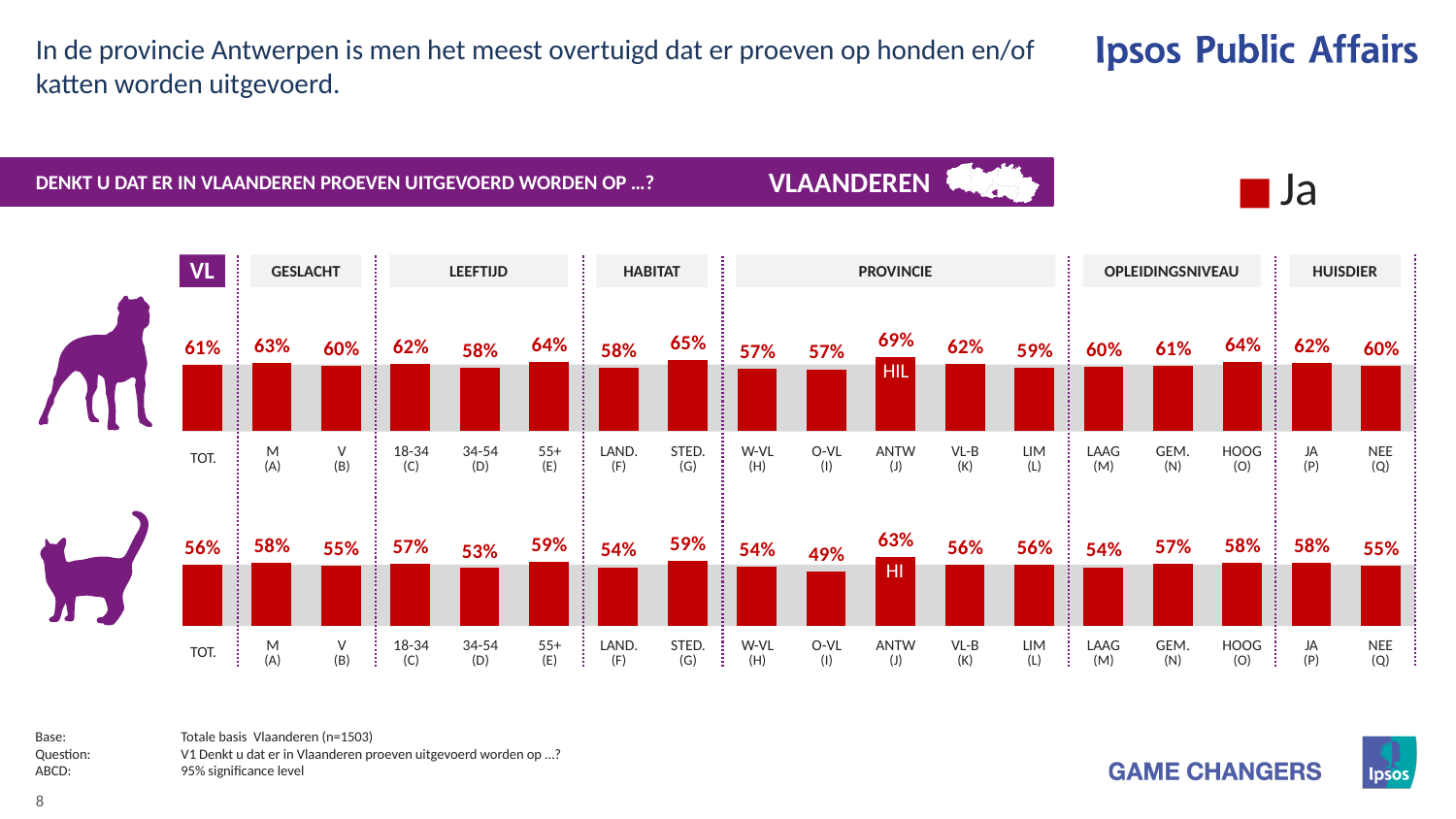
In the top chart (dogs), which province has the highest value? ANTW What type of chart is used on this slide? Bar chart In the bottom chart (cats), which is larger: the value for 18-34 or the value for 34-54? 18-34 In the bottom chart (cats), which province has the lowest value? O-VL In the top chart (dogs), what percentage of respondents in the province of Antwerpen (ANTW) answered 'Ja'? 69% In the bottom chart (cats), what is the difference between the ANTW value and the O-VL value? 14 percentage points In the top chart (dogs), what is the value for respondents with a HOOG education level? 64% In the top chart (dogs), what is the value for the 55+ age group? 64% In the bottom chart (cats), what is the value for the total Vlaanderen (TOT.) bar? 56% How many categories are shown in the PROVINCIE group of the top chart (dogs)? 5 What is the only legend entry shown on the slide? Ja In the top chart (dogs), what is the difference between the STED. and LAND. values in the HABITAT group? 7 percentage points